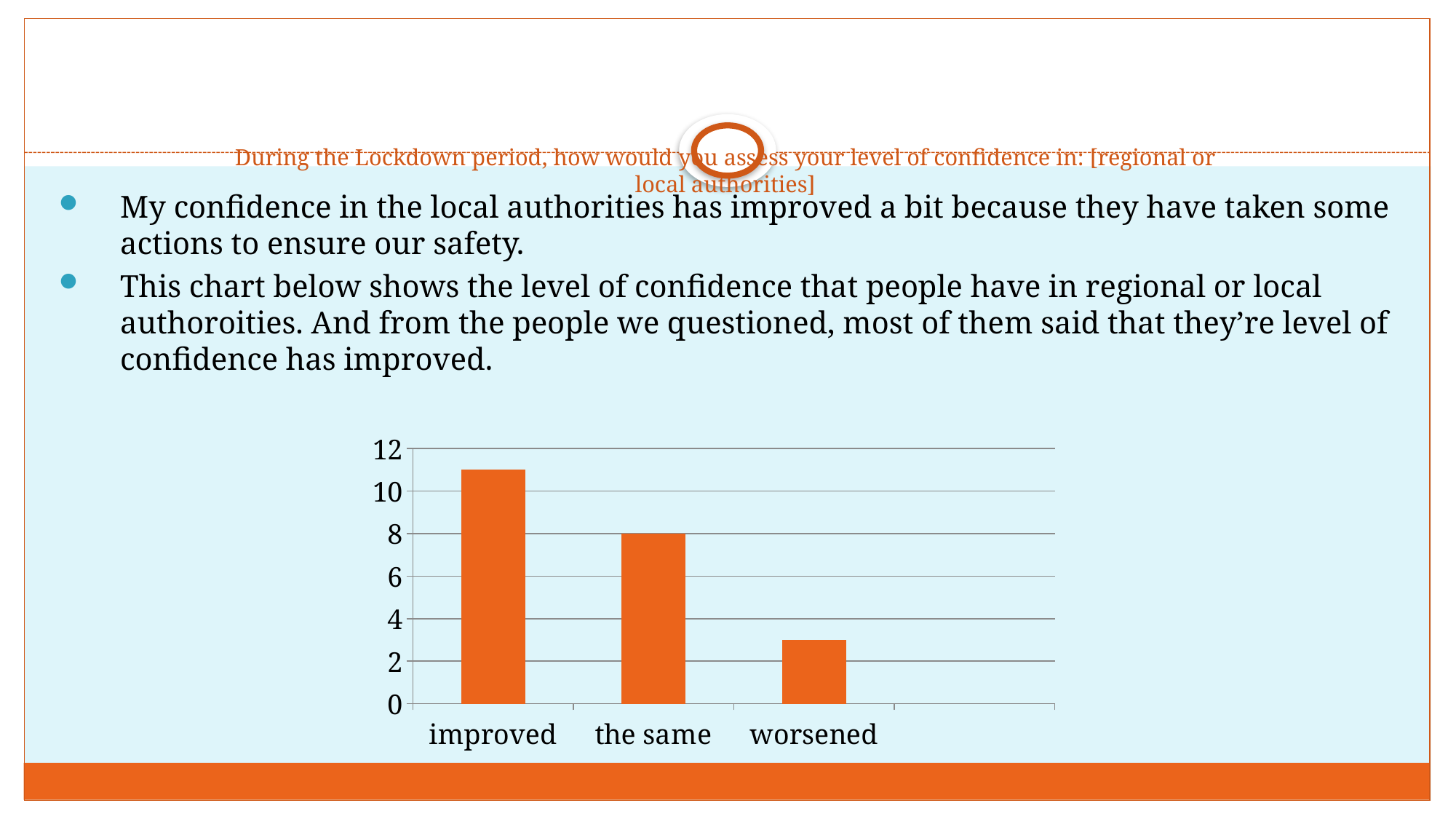
What kind of chart is shown on the slide? bar chart Is the value for "improved" greater or less than 10? greater Which category has the lowest bar in the chart? worsened What is the value for "the same" in the chart? 8 Which is larger, the value for "improved" or the value for "the same"? improved Is the value for "worsened" greater or less than 2? greater What is the highest value shown on the chart's vertical axis? 12 How many categories are shown on the x axis of the chart? 3 Do the bar values rise or fall from left to right along the x axis? fall Which category has the highest bar in the chart? improved Which is larger, the value for "the same" or the value for "worsened"? the same Is the value for "worsened" greater or less than 4? less